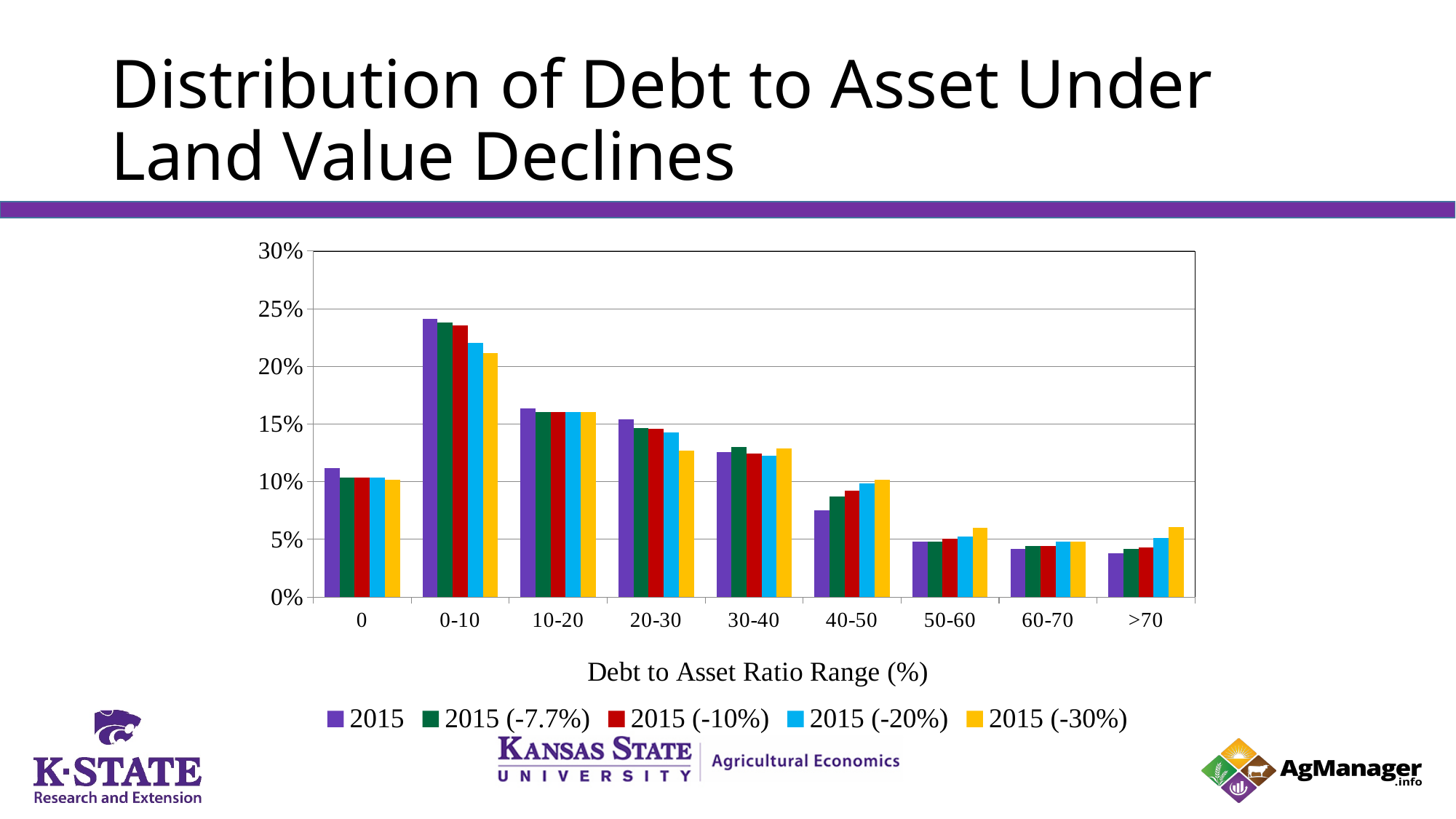
Is the value for the 2015 series in the 0 range greater or less than 10%? greater Is the value for the 2015 (-30%) series in the 20-30 range greater or less than 15%? less For the 2015 series, which debt to asset ratio range has the highest value? 0-10 In the 40-50 range, which is larger: the 2015 value or the 2015 (-30%) value? 2015 (-30%) In the >70 range, which series has the highest value? 2015 (-30%) What kind of chart is shown on the slide? bar chart How many series does the legend list? 5 Is the value for the 2015 series in the 0-10 range greater or less than 20%? greater In the 0-10 range, which is larger: the 2015 value or the 2015 (-30%) value? 2015 For the 2015 series, which debt to asset ratio range has the lowest value? >70 What is the title of the x axis? Debt to Asset Ratio Range (%) How many debt to asset ratio range categories are shown on the x axis? 9